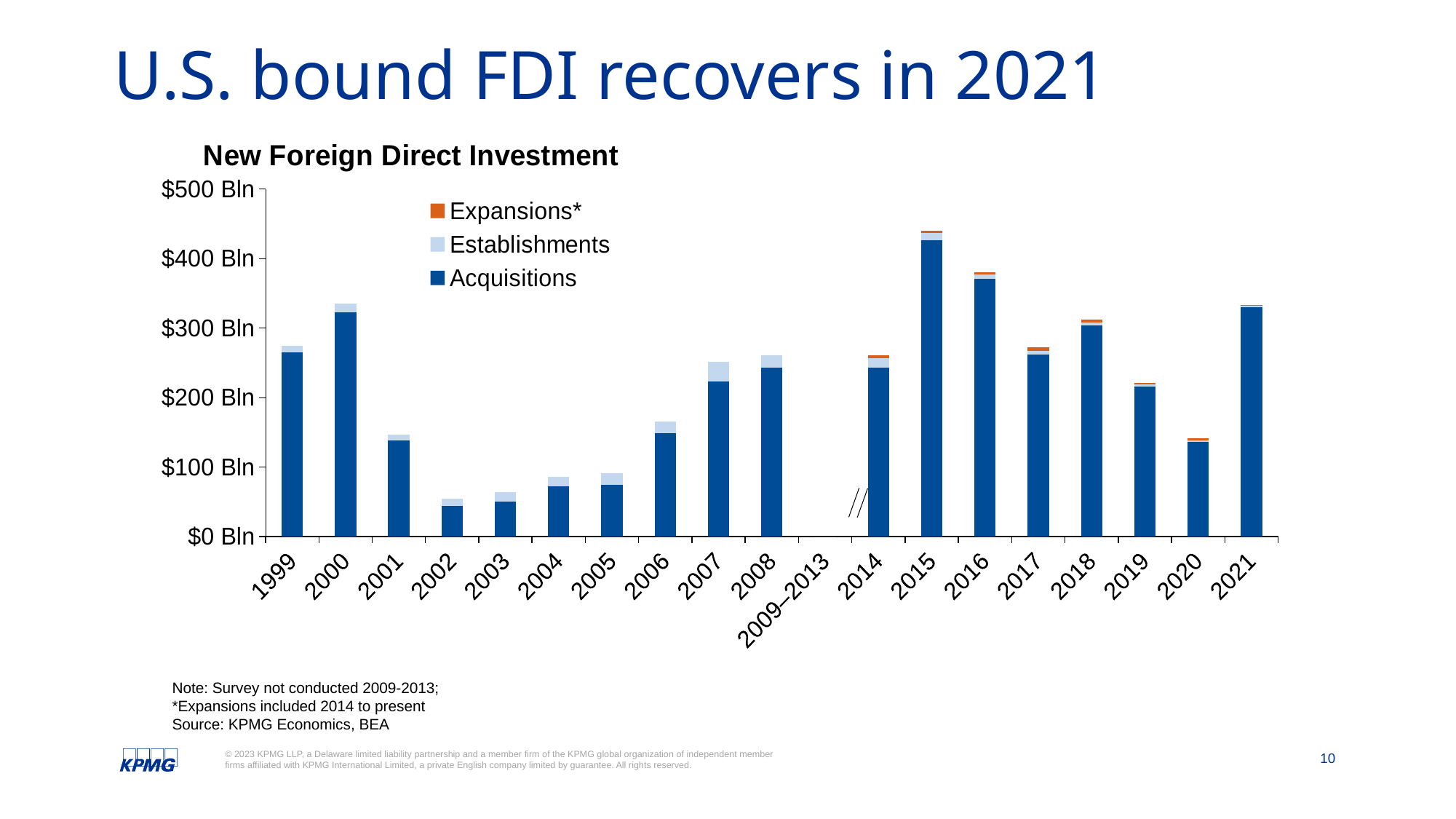
Is the total value for 2021 greater or less than $300 Bln? greater Which series is shown in orange in the legend? Expansions* Is the total value for 2016 greater or less than $400 Bln? less Which year has a larger total bar, 2014 or 2019? 2014 Which year has the highest total bar? 2015 Which year has the lowest total bar? 2002 Is the total value for 2002 greater or less than $100 Bln? less Do the total values rise or fall from 2002 to 2008? rise What kind of chart is shown on the slide? Stacked bar chart How many series does the chart's legend list? 3 What is the title of the chart? New Foreign Direct Investment